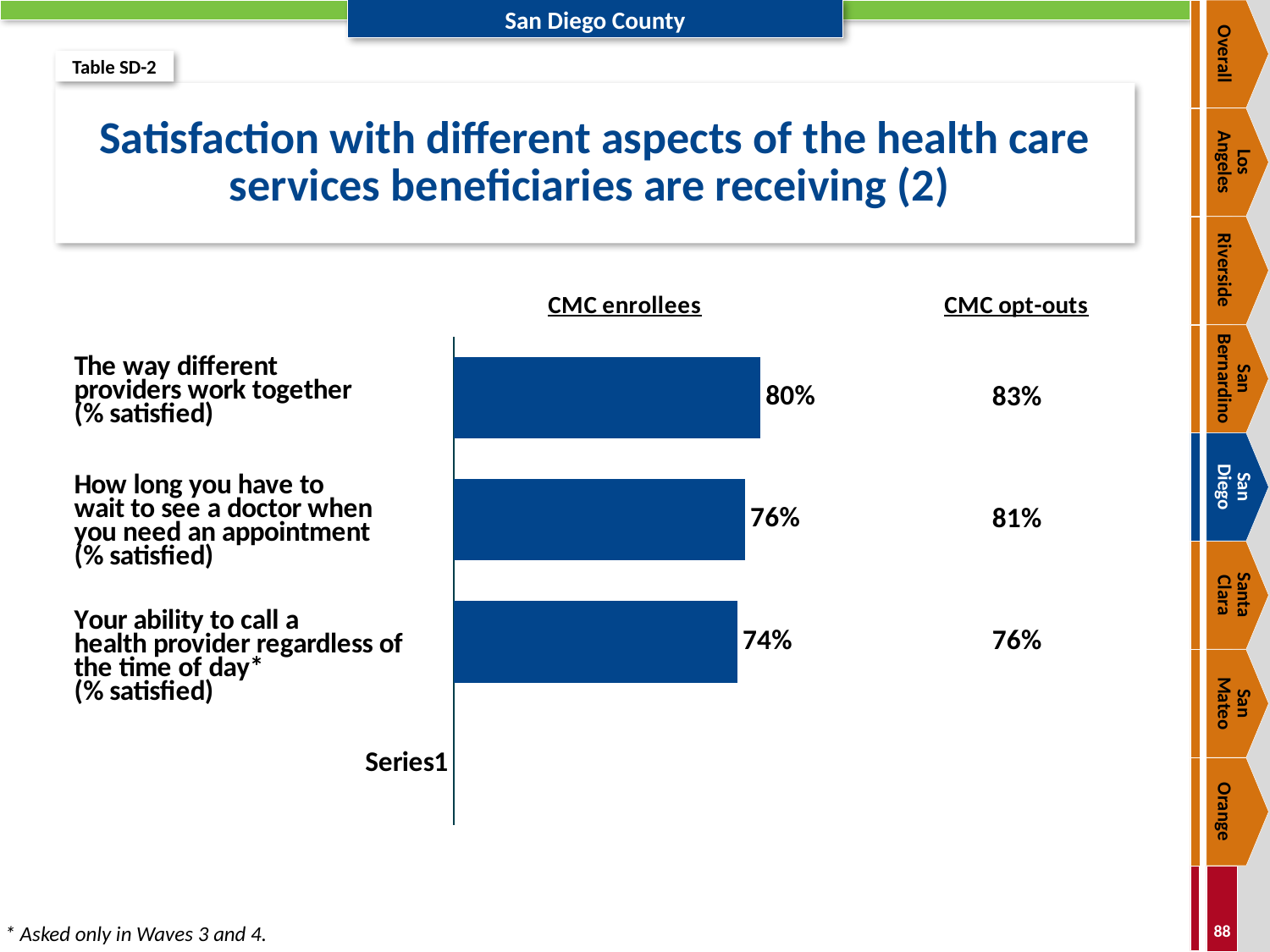
For 'Your ability to call a health provider regardless of the time of day* (% satisfied)', which group has the larger value, CMC enrollees or CMC opt-outs? CMC opt-outs Which aspect has the lowest CMC enrollees satisfaction value? Your ability to call a health provider regardless of the time of day* (% satisfied) Which aspect has the highest CMC enrollees satisfaction value? The way different providers work together (% satisfied) What is the CMC opt-outs value for 'The way different providers work together (% satisfied)'? 83% What is the CMC enrollees value for 'Your ability to call a health provider regardless of the time of day* (% satisfied)'? 74% What kind of chart is shown on the slide? bar chart What is the difference between the CMC opt-outs and CMC enrollees values for 'How long you have to wait to see a doctor when you need an appointment (% satisfied)'? 5% What is the CMC enrollees value for 'How long you have to wait to see a doctor when you need an appointment (% satisfied)'? 76% How many bars are plotted in the chart? 3 What is the CMC enrollees value for 'The way different providers work together (% satisfied)'? 80% What is the title of the chart on the slide? Satisfaction with different aspects of the health care services beneficiaries are receiving (2) What is the CMC opt-outs value for 'How long you have to wait to see a doctor when you need an appointment (% satisfied)'? 81%